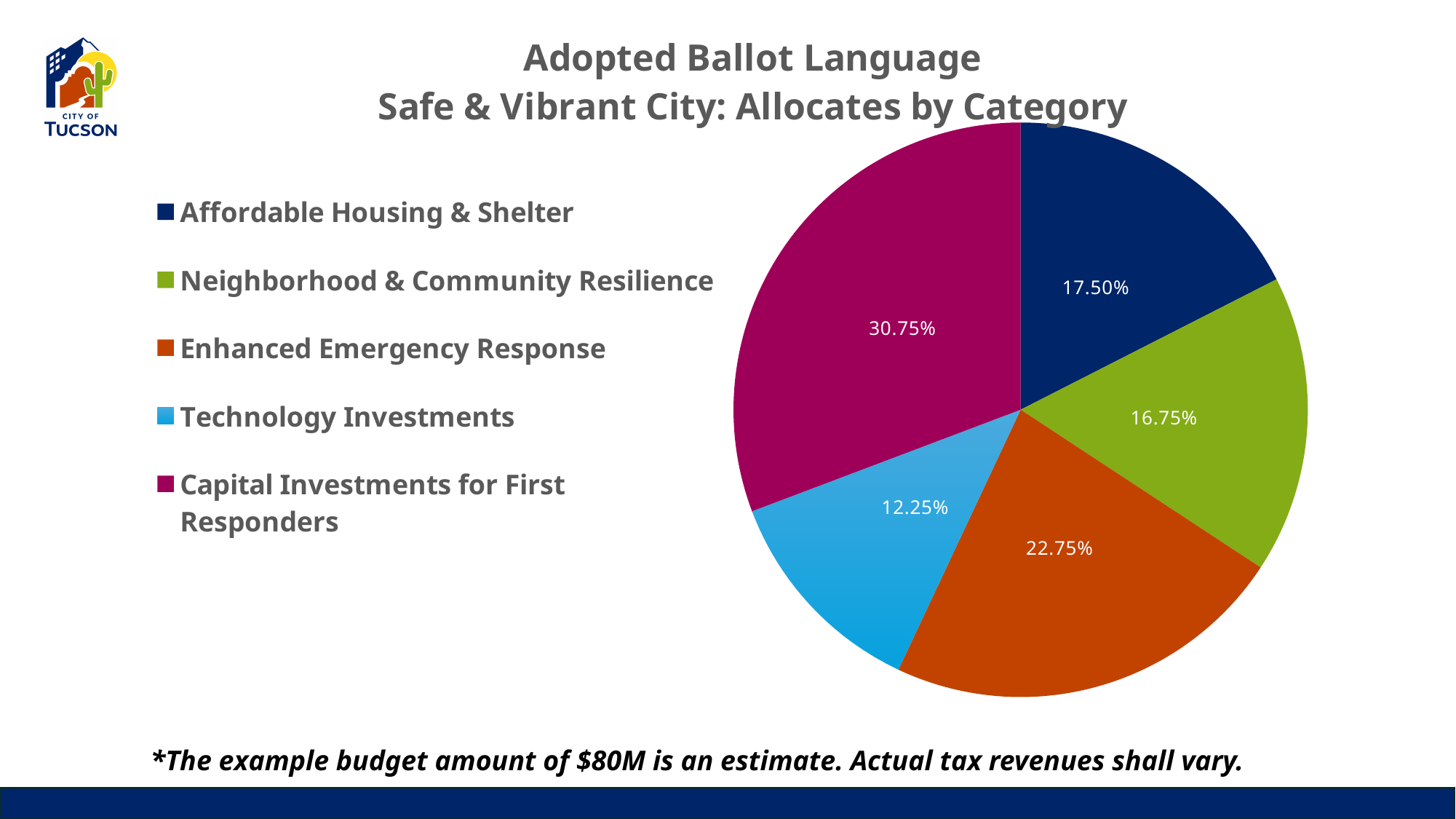
What is the difference between the shares for Capital Investments for First Responders and Enhanced Emergency Response? 8.00% Which category has the largest share of the pie? Capital Investments for First Responders What share of the pie is allocated to Neighborhood & Community Resilience? 16.75% What share of the pie is allocated to Enhanced Emergency Response? 22.75% Which is larger, the share for Affordable Housing & Shelter or the share for Technology Investments? Affordable Housing & Shelter What kind of chart is shown on the slide? Pie chart What share of the pie is allocated to Affordable Housing & Shelter? 17.50% What share of the pie is allocated to Capital Investments for First Responders? 30.75% What share of the pie is allocated to Technology Investments? 12.25% How many categories are shown in the pie chart? 5 Which category has the smallest share of the pie? Technology Investments What colour is the slice for Enhanced Emergency Response? Orange